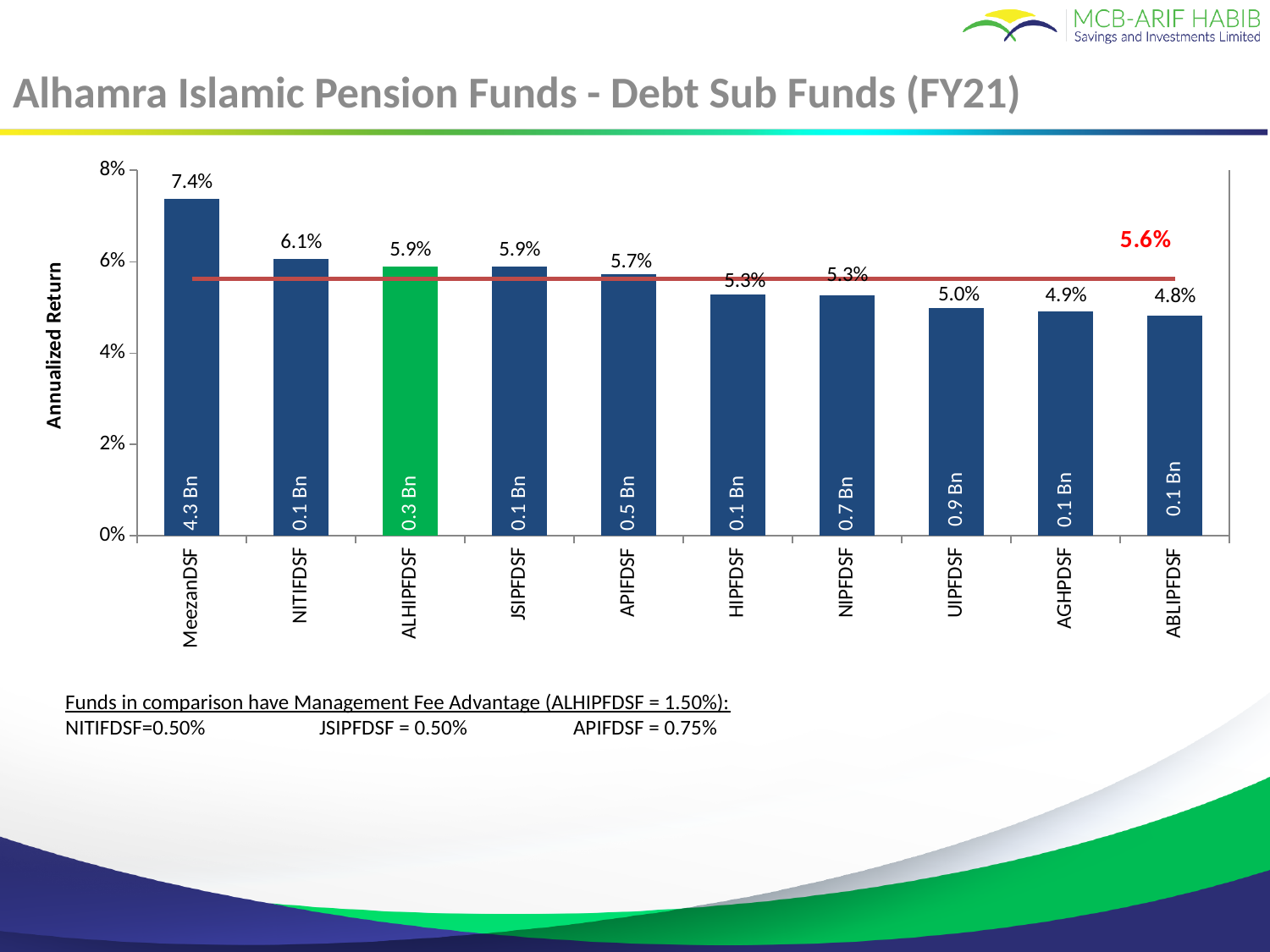
What is the difference in annualized return between MeezanDSF and NITIFDSF? 1.3% What value is labelled on the red horizontal line? 5.6% What kind of chart is shown on the slide? Bar chart What is the annualized return for MeezanDSF? 7.4% What fund size is printed inside the bar for UIPFDSF? 0.9 Bn Which has a higher annualized return, APIFDSF or AGHPDSF? APIFDSF Which fund's bar is coloured green? ALHIPFDSF What is the annualized return for ABLIPFDSF? 4.8% How many funds are shown on the chart? 10 Which fund has the lowest annualized return? ABLIPFDSF What is the annualized return for ALHIPFDSF? 5.9% Which fund has the highest annualized return? MeezanDSF